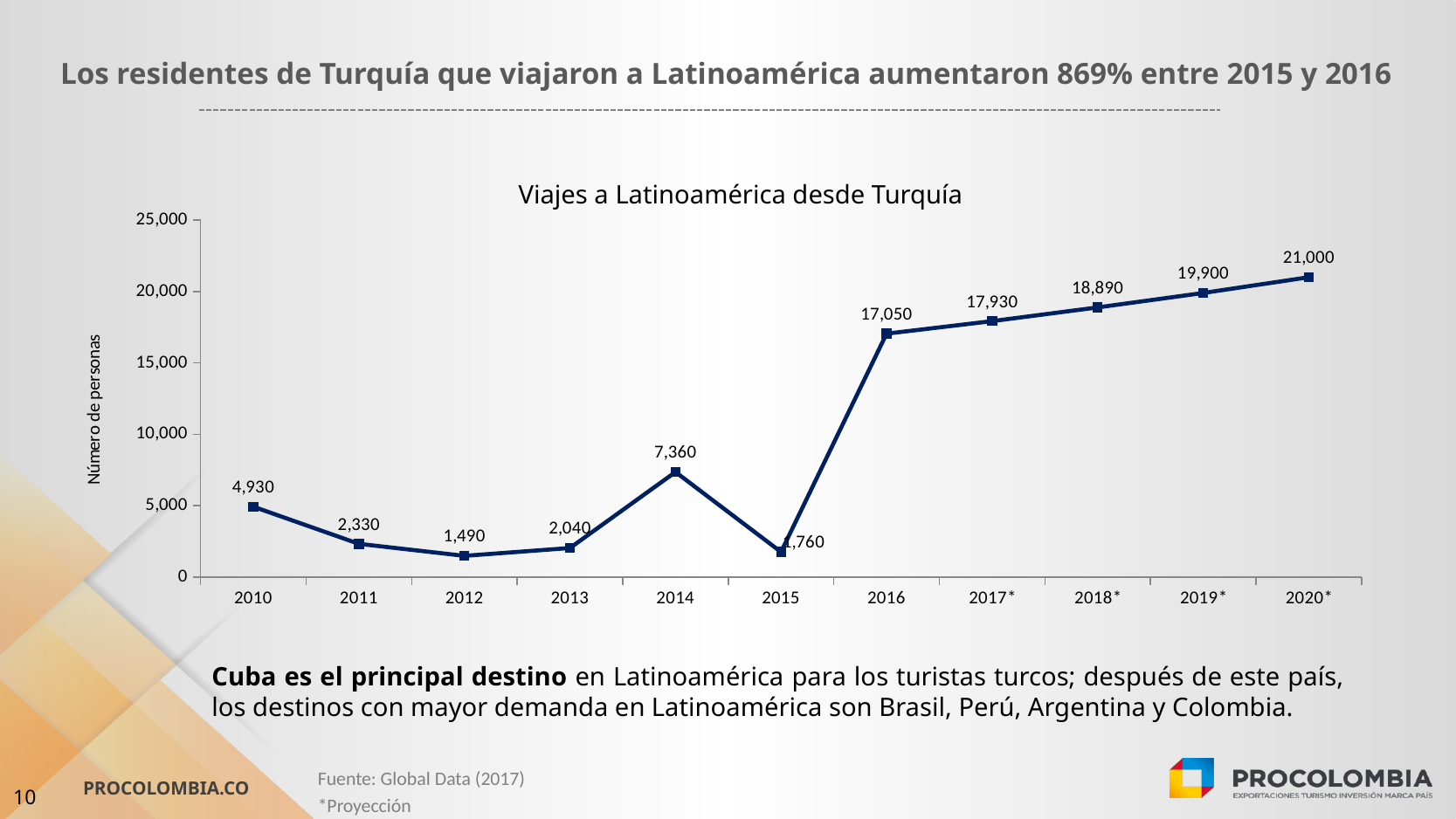
Which is larger, the value for 2014 or the value for 2011? 2014 What is the value for 2020*? 21,000 What kind of chart is shown? line chart Which year has the lowest value? 2012 How many years are plotted on the x axis? 11 Do the values rise or fall from 2016 to 2020*? rise What is the value for 2016 in the chart? 17,050 Is the value for 2018* greater or less than 15,000? greater Which year has the highest value? 2020* What is the title of the chart? Viajes a Latinoamérica desde Turquía What is the value for 2012 in the chart? 1,490 What is the difference between the values for 2016 and 2015? 15,290